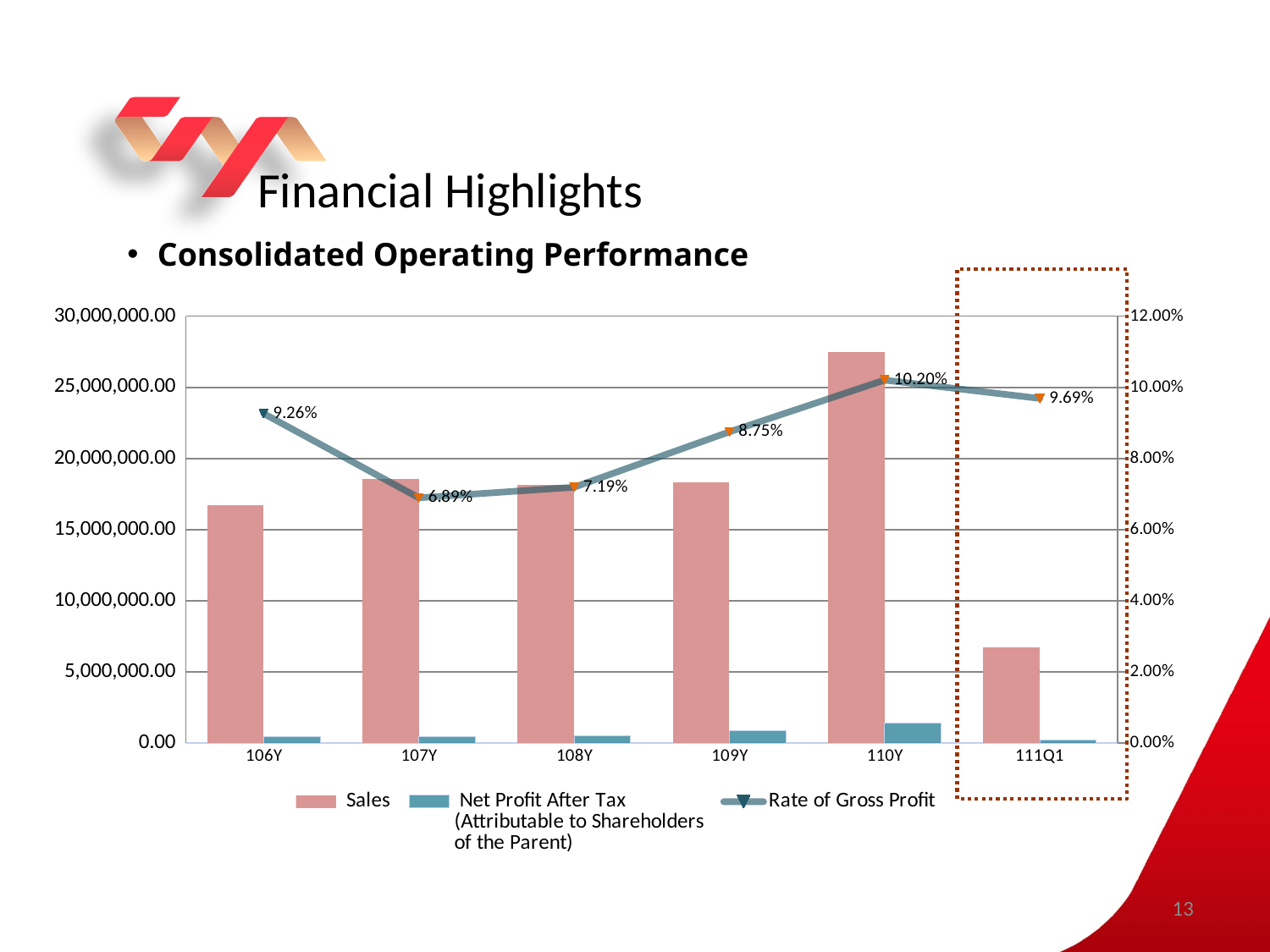
What is the Rate of Gross Profit for 110Y? 10.20% Which period has the larger Rate of Gross Profit, 108Y or 109Y? 109Y Is the Sales value for 106Y greater or less than 20,000,000.00? less What is the difference between the Rate of Gross Profit in 110Y and in 107Y? 3.31% Which period has the lowest Rate of Gross Profit? 107Y Which period has the highest Sales bar? 110Y What is the Rate of Gross Profit for 111Q1? 9.69% How many series does the legend list? 3 Is the Sales value for 110Y greater or less than 25,000,000.00? greater How many periods are shown on the x axis? 6 Which period has the highest Rate of Gross Profit? 110Y What is the Rate of Gross Profit for 107Y? 6.89%